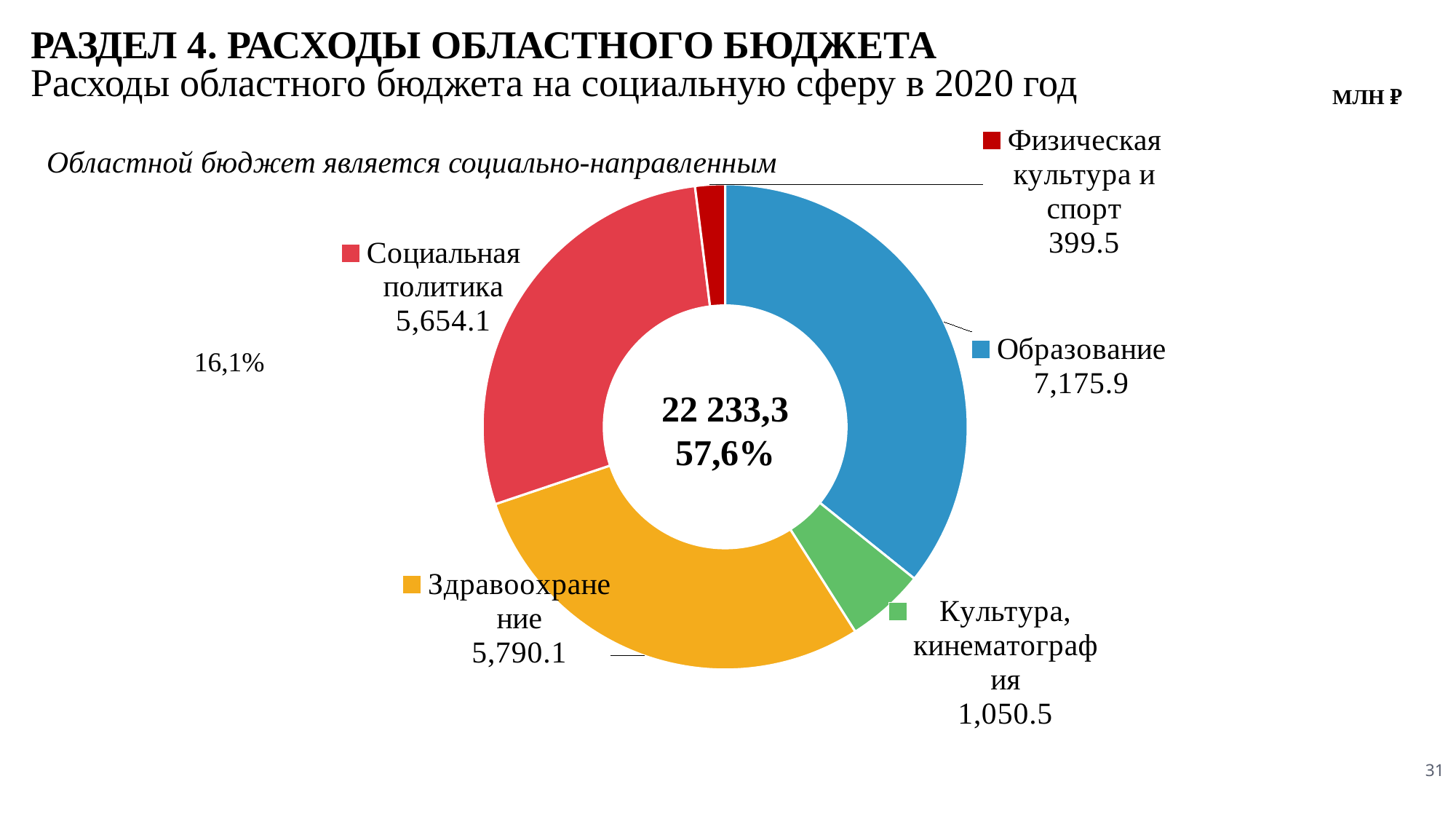
Which category has the highest value? Образование What is the value for Здравоохранение? 5,790.1 What is the value for Образование? 7,175.9 Which category has the lowest value? Физическая культура и спорт What is the value for Социальная политика? 5,654.1 What is the value for Физическая культура и спорт? 399.5 How many categories does the chart show? 5 Which is larger, Здравоохранение or Социальная политика? Здравоохранение What kind of chart is shown on the slide? Doughnut (pie) chart What is the difference between Образование and Здравоохранение? 1,385.8 What is the value for Культура, кинематография? 1,050.5 What number is printed in the centre of the doughnut chart? 22 233,3 and 57,6%